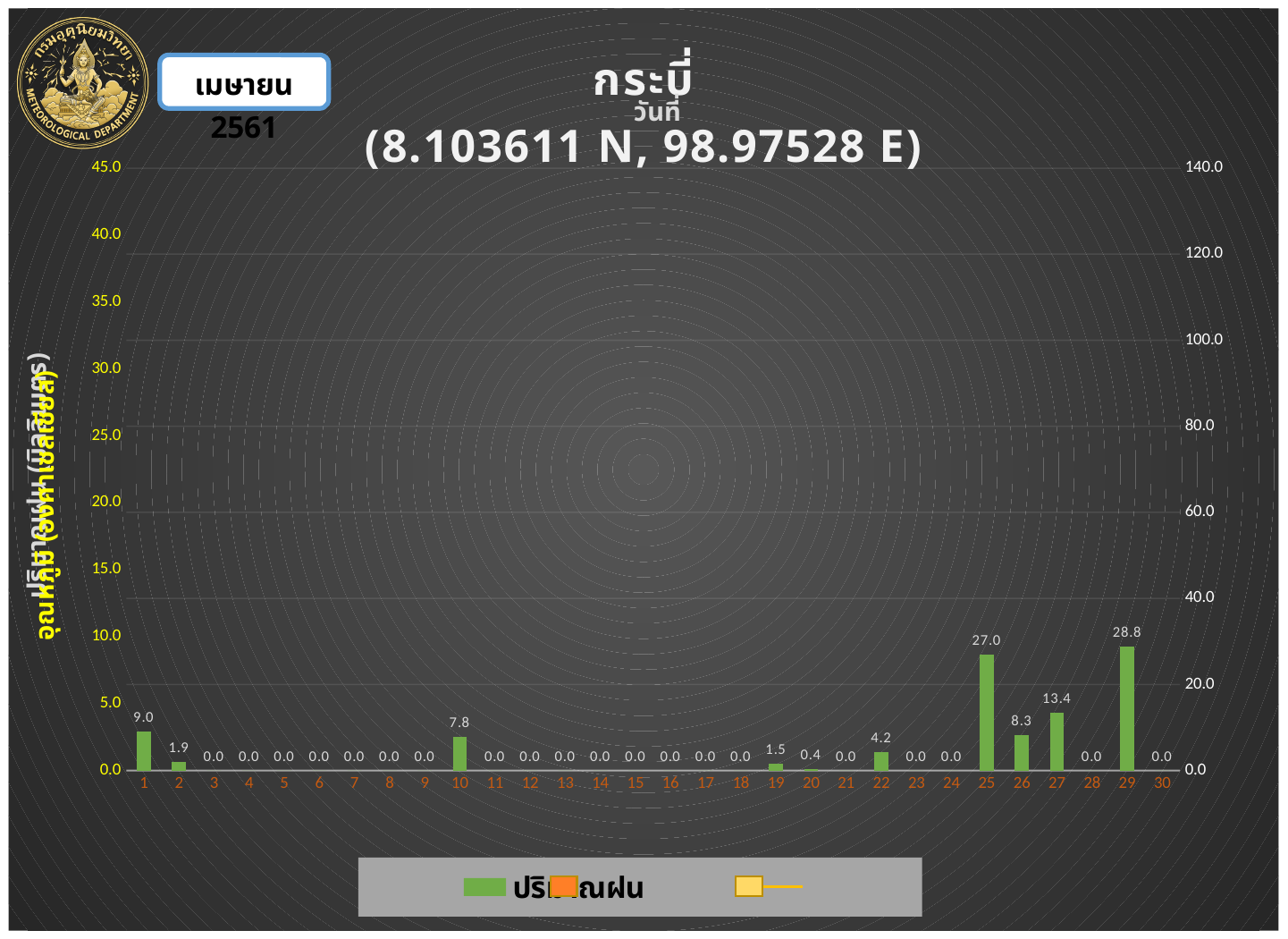
What kind of chart is used to show the rainfall values? bar chart What is the rainfall value shown for day 25? 27.0 What is the rainfall value shown for day 1? 9.0 What is the difference between the rainfall values for day 27 and day 26? 5.1 How many days are shown on the x axis? 30 Which has a larger rainfall value, day 22 or day 26? day 26 What is the rainfall value shown for day 27? 13.4 What is the rainfall value shown for day 10? 7.8 Which day has the highest rainfall value? 29 Which has a larger rainfall value, day 1 or day 10? day 1 What is the rainfall value shown for day 20? 0.4 What is the difference between the rainfall values for day 29 and day 25? 1.8